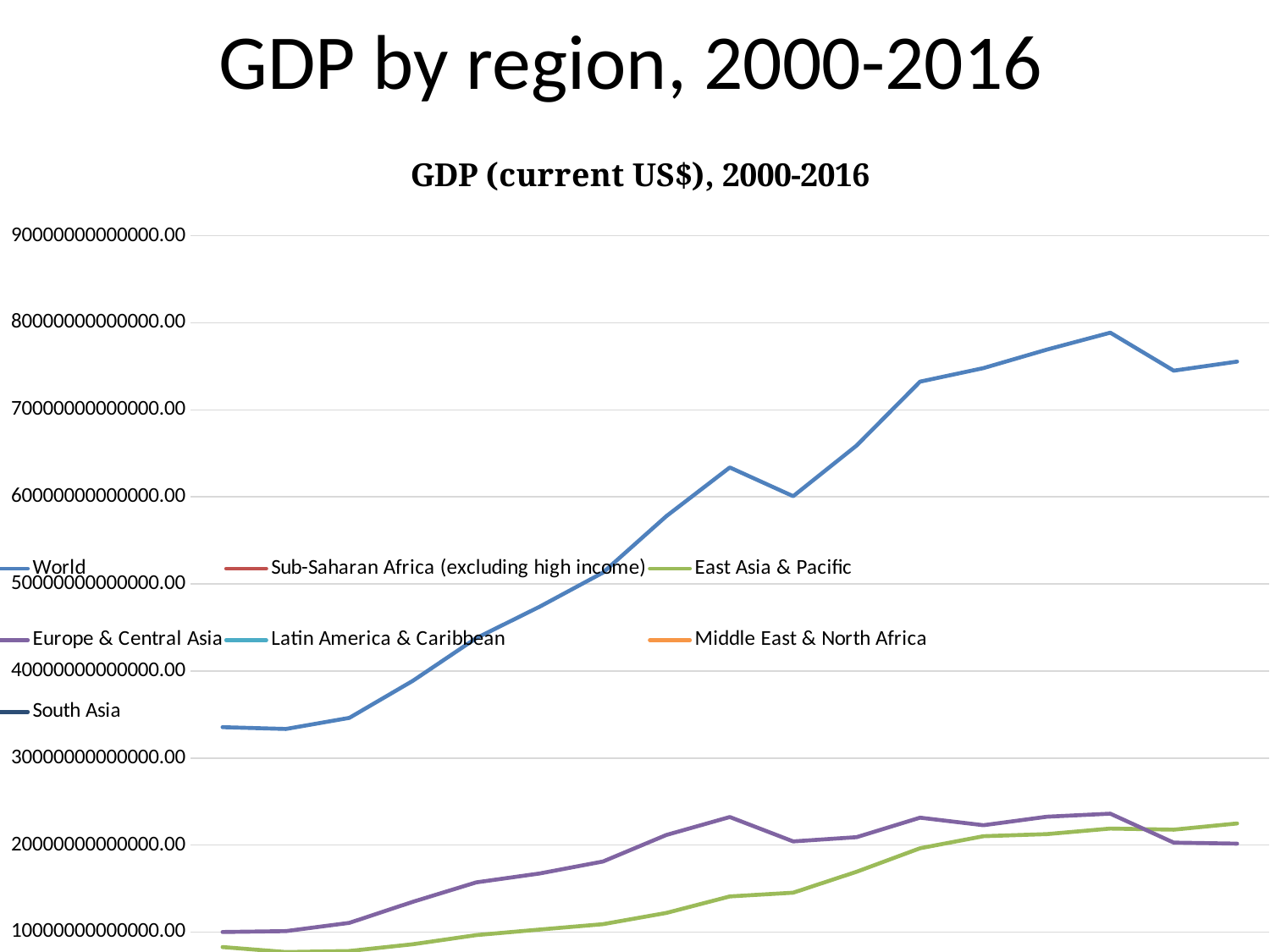
Is the last (rightmost) value of the East Asia & Pacific series greater or less than 200000000000000.00? greater Is the first (leftmost) value of the World series greater or less than 400000000000000.00? less Does the East Asia & Pacific series generally rise or fall from left to right? Rise Is the highest point of the World series greater or less than 700000000000000.00? greater Which series is higher throughout the chart, World or Europe & Central Asia? World How many series does the legend list? 7 What is the title of the chart? GDP (current US$), 2000-2016 Does the World series generally rise or fall from left to right? Rise What kind of chart is shown on the slide? Line chart Which series has the highest values on the chart? World What colour is the line for the World series? Blue